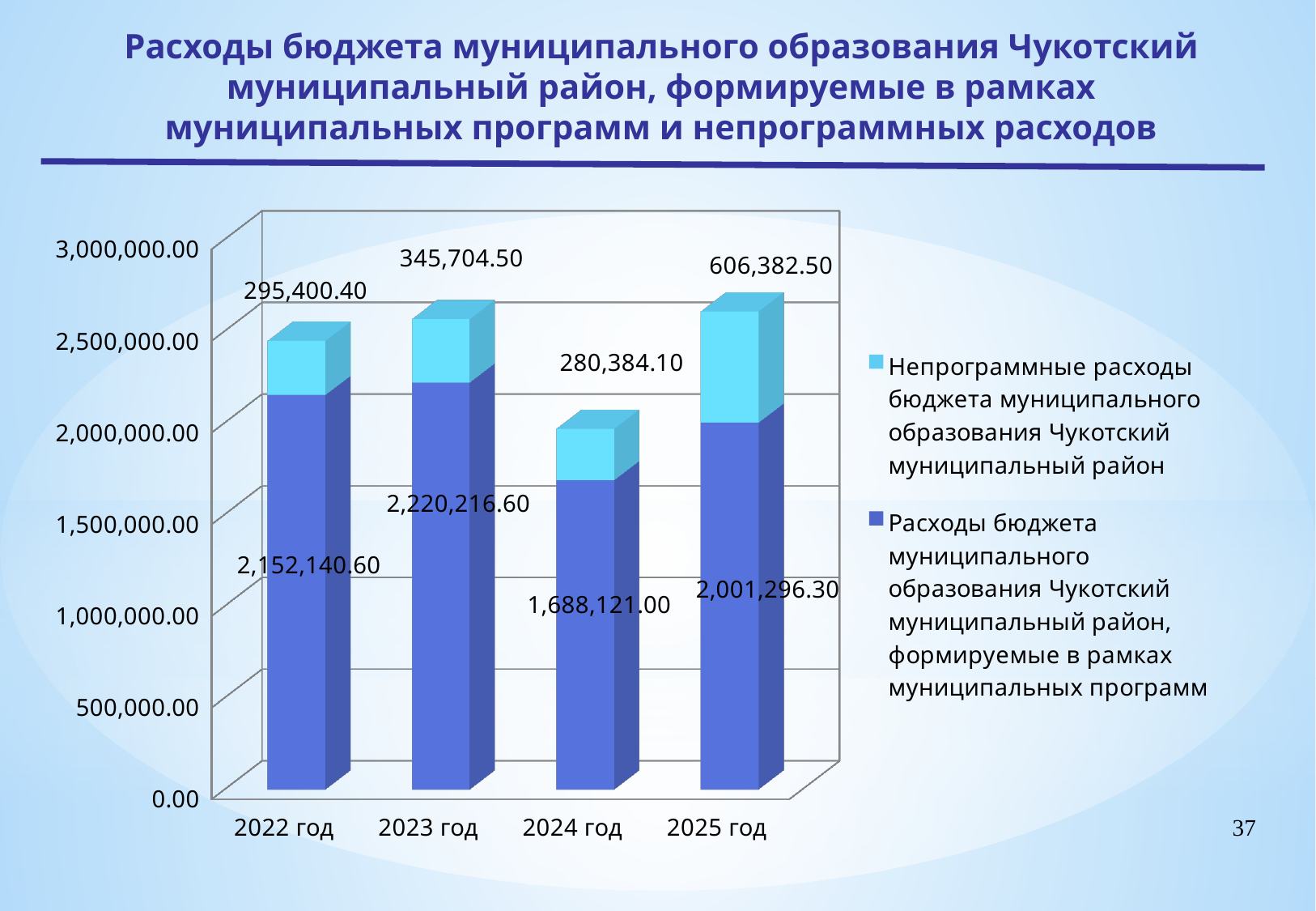
How many years (categories) are shown on the x axis? 4 In which year is the value of 'Расходы бюджета ... формируемые в рамках муниципальных программ' the lowest? 2024 год What is the value of 'Расходы бюджета ... формируемые в рамках муниципальных программ' for 2024 год? 1,688,121.00 What is the value of 'Непрограммные расходы' for 2025 год? 606,382.50 What is the total of the stacked bar for 2025 год? 2,607,678.80 How many series does the legend list? 2 What is the value of 'Непрограммные расходы' for 2022 год? 295,400.40 Which is larger: 'Непрограммные расходы' in 2023 год or in 2024 год? 2023 год Is the total stacked bar for 2024 год greater or less than 2,000,000.00? less What is the difference between the program expenditure values for 2023 год and 2022 год? 68,076.00 In which year is the value of 'Непрограммные расходы' the highest? 2025 год What type of chart is shown on the slide? Stacked bar chart